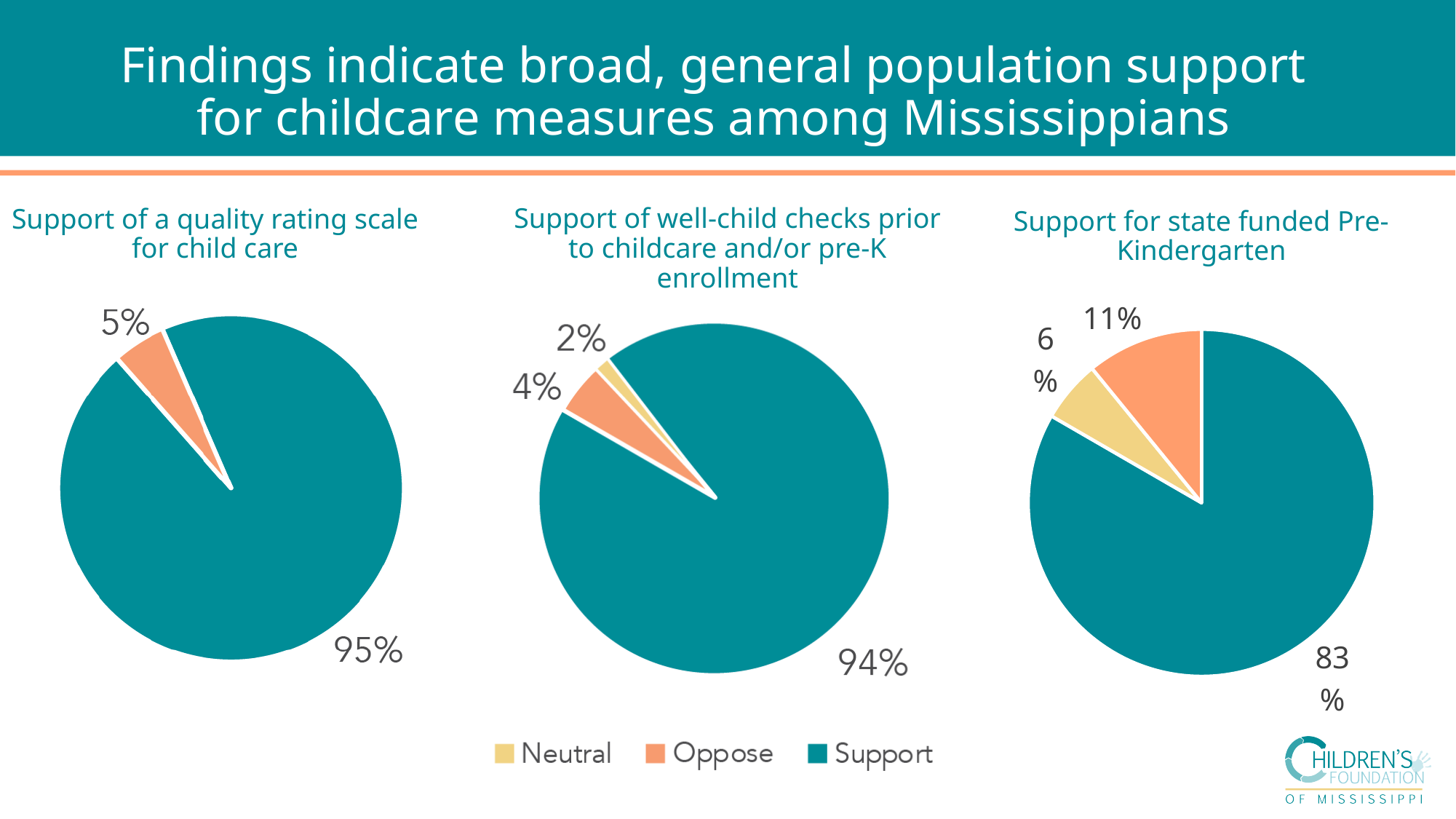
In the 'Support for state funded Pre-Kindergarten' chart, what share of respondents support it? 83% In the 'Support of well-child checks prior to childcare and/or pre-K enrollment' chart, what share is Oppose? 4% In the 'Support for state funded Pre-Kindergarten' chart, what share of respondents oppose it? 11% In the 'Support of well-child checks prior to childcare and/or pre-K enrollment' chart, what share is Neutral? 2% In the 'Support of a quality rating scale for child care' chart, what share of respondents oppose it? 5% In the 'Support for state funded Pre-Kindergarten' chart, which category has the smallest slice? Neutral Which is larger: the Oppose share in the 'Support for state funded Pre-Kindergarten' chart or the Oppose share in the 'Support of a quality rating scale for child care' chart? Support for state funded Pre-Kindergarten In the 'Support of well-child checks prior to childcare and/or pre-K enrollment' chart, which category has the largest slice? Support What is the difference between the Support share in the 'Support of a quality rating scale for child care' chart and the Support share in the 'Support for state funded Pre-Kindergarten' chart? 12% How many categories does the legend list for the pie charts? 3 In the 'Support of a quality rating scale for child care' chart, what share of respondents support it? 95% What type of chart is used for 'Support for state funded Pre-Kindergarten'? Pie chart